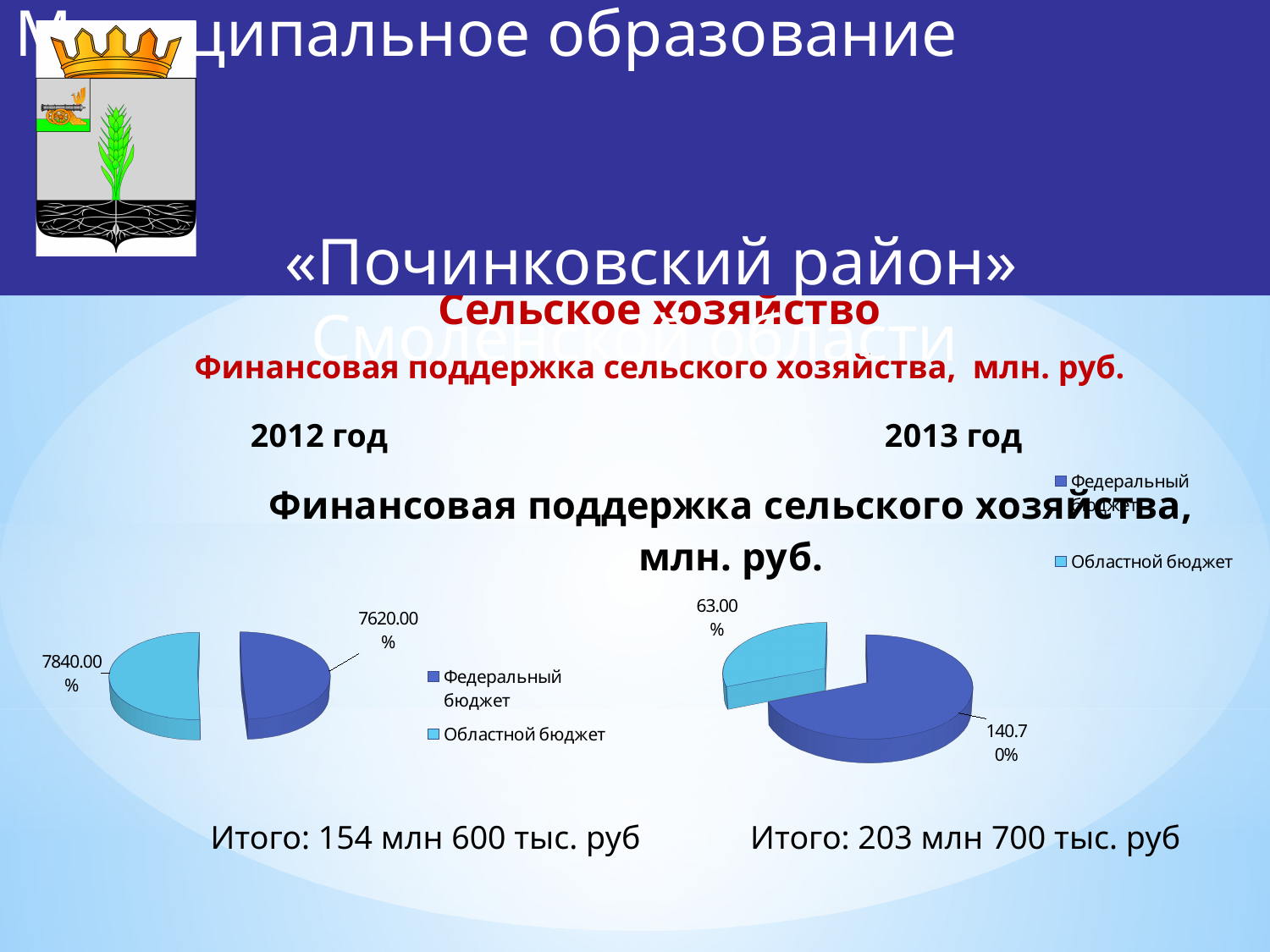
What total (Итого) is shown under the 2013 год pie chart? 203 млн 700 тыс. руб How many entries does the legend of the 2012 год pie chart list? 2 In the 2012 год pie chart, what is the value labelled for Областной бюджет? 7840.00% In the 2013 год pie chart, what is the difference between the labelled values for Федеральный бюджет and Областной бюджет? 77.70% In the 2013 год pie chart, which slice is the largest? Федеральный бюджет In the 2013 год pie chart, what is the value labelled for Федеральный бюджет? 140.70% In the 2012 год pie chart, which has the larger labelled value, Федеральный бюджет or Областной бюджет? Областной бюджет How many slices does the 2013 год pie chart have? 2 In the 2013 год pie chart, which slice is the smallest? Областной бюджет In the 2013 год pie chart, what is the value labelled for Областной бюджет? 63.00% In the 2012 год pie chart, what is the value labelled for Федеральный бюджет? 7620.00% What kind of chart is used for the 2012 год data on the slide? pie chart